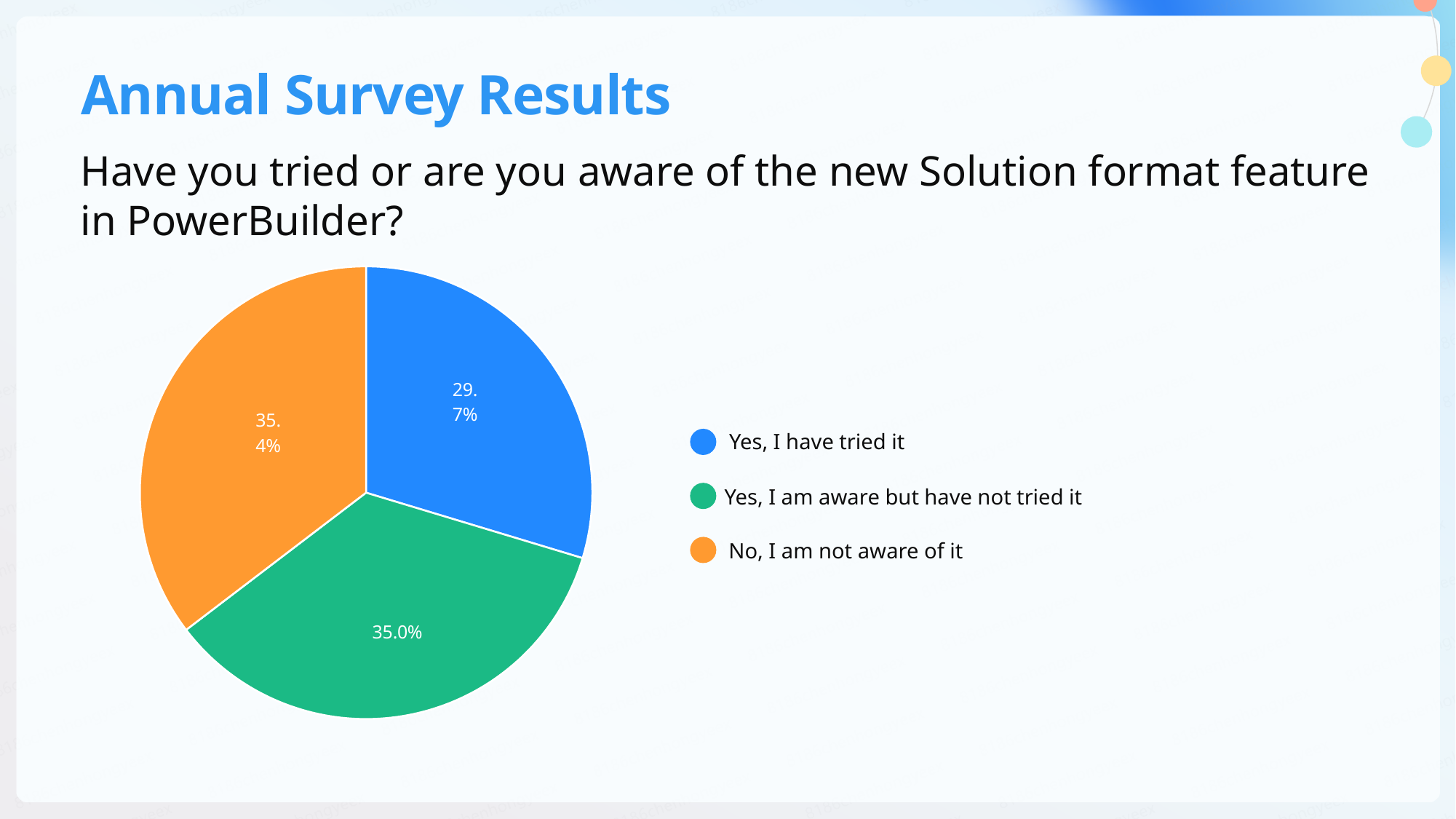
What kind of chart is shown on the slide? Pie chart What percentage of respondents answered "Yes, I am aware but have not tried it"? 35.0% What percentage of respondents answered "Yes, I have tried it"? 29.7% Which response has the largest share of the pie? No, I am not aware of it What is the difference in percentage points between "Yes, I am aware but have not tried it" and "Yes, I have tried it"? 5.3 What is the difference in percentage points between "No, I am not aware of it" and "Yes, I have tried it"? 5.7 How many slices does the pie chart have? 3 What colour is the slice for "No, I am not aware of it"? Orange Which is larger: the share for "Yes, I am aware but have not tried it" or the share for "Yes, I have tried it"? Yes, I am aware but have not tried it Which response has the smallest share of the pie? Yes, I have tried it How many entries does the legend list? 3 What percentage of respondents answered "No, I am not aware of it"? 35.4%